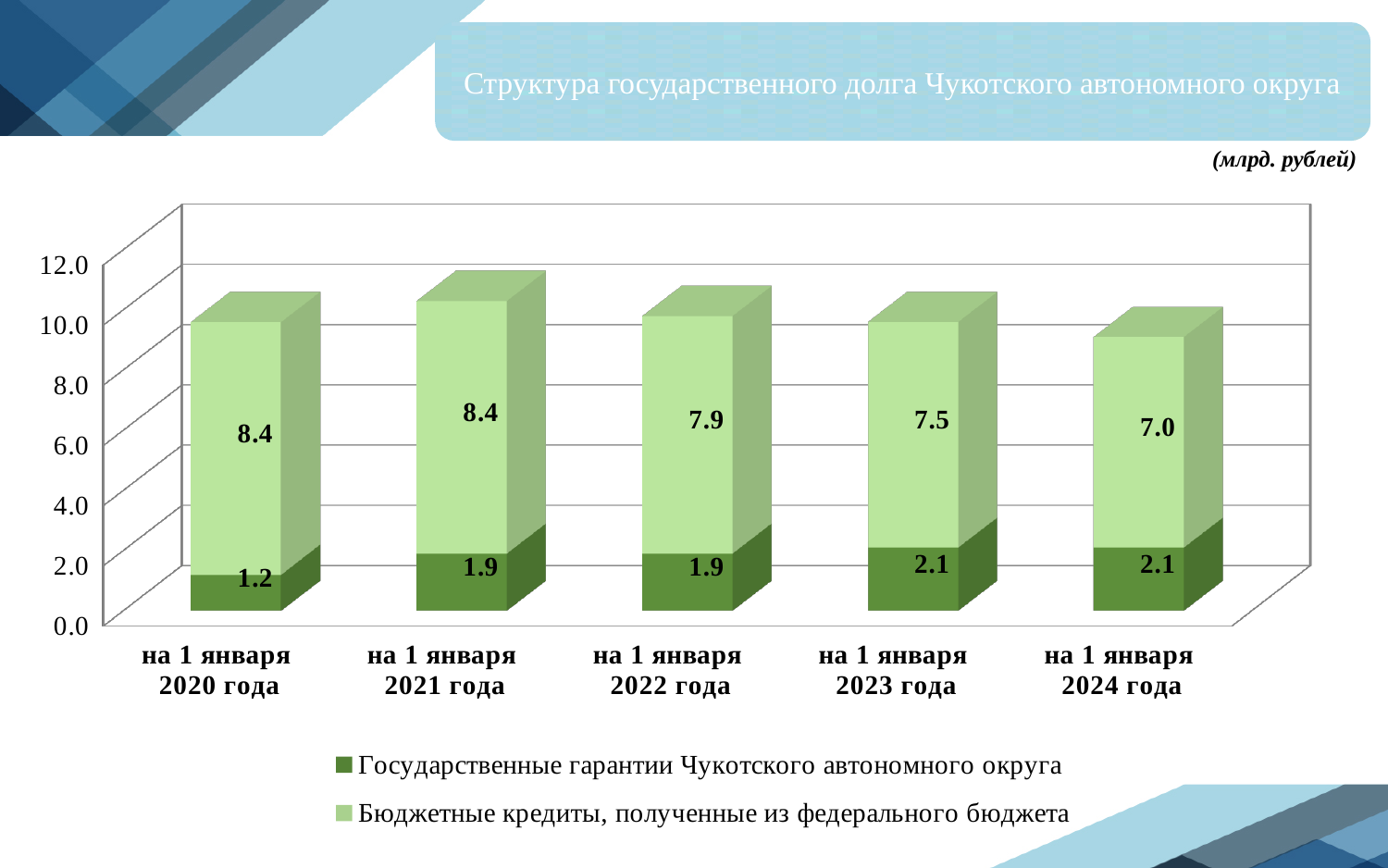
Does the value of 'Бюджетные кредиты, полученные из федерального бюджета' rise or fall from 1 January 2021 to 1 January 2024? fall What is the difference between the 'Бюджетные кредиты' values on 1 January 2021 and 1 January 2024? 1.4 What is the total of the stacked bar for 1 January 2024? 9.1 How many dates are shown on the x axis? 5 In which year is the value of 'Государственные гарантии Чукотского автономного округа' lowest? на 1 января 2020 года What is the value of 'Бюджетные кредиты, полученные из федерального бюджета' on 1 January 2020? 8.4 What is the total of the stacked bar for 1 January 2021? 10.3 Which is larger: 'Государственные гарантии' on 1 January 2020 or on 1 January 2023? на 1 января 2023 года What is the value of 'Государственные гарантии Чукотского автономного округа' on 1 January 2024? 2.1 How many series does the legend list? 2 In which year is the value of 'Бюджетные кредиты, полученные из федерального бюджета' lowest? на 1 января 2024 года What is the value of 'Государственные гарантии Чукотского автономного округа' on 1 January 2022? 1.9